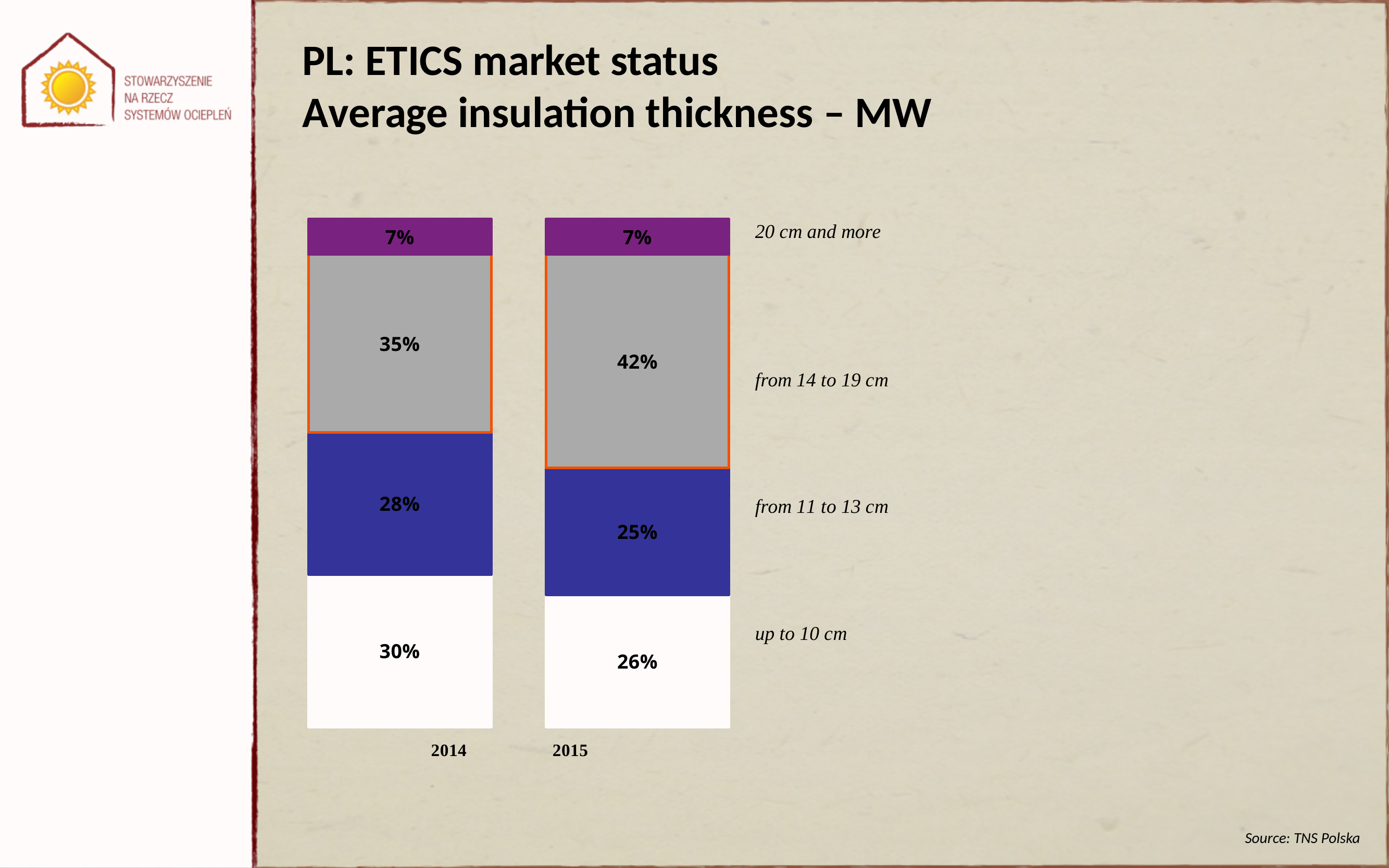
Which thickness category has the largest share in 2015? from 14 to 19 cm What share of the 2014 bar is 'from 14 to 19 cm'? 35% What is the value for 'up to 10 cm' in 2015? 26% What share of the 2015 bar is 'from 14 to 19 cm'? 42% Which year has the larger share for 'up to 10 cm', 2014 or 2015? 2014 By how many percentage points did the 'from 14 to 19 cm' share change from 2014 to 2015? 7 percentage points Which thickness category has the smallest share in 2014? 20 cm and more How many years (bars) are shown in the chart? 2 What is the value for 'from 11 to 13 cm' in 2014? 28% What is the value for '20 cm and more' in 2015? 7% What type of chart is shown on the slide? Stacked bar chart How many thickness categories are shown in each bar? 4